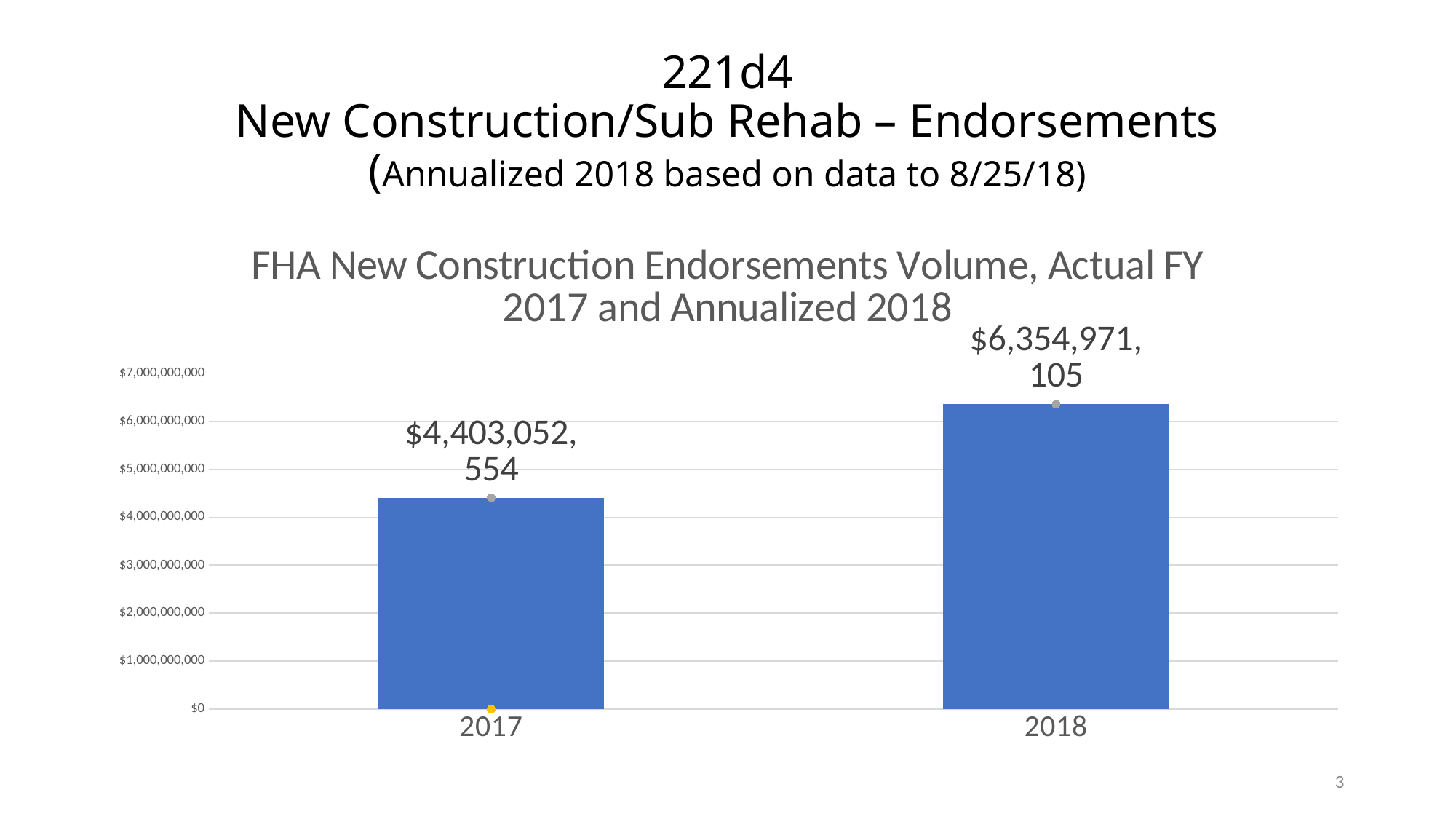
Do the values rise or fall from 2017 to 2018? rise What kind of chart is shown? bar chart What is the title of the chart? FHA New Construction Endorsements Volume, Actual FY 2017 and Annualized 2018 Which year has the higher endorsement volume? 2018 What is the value for 2018? $6,354,971,105 Is the value for 2017 larger or smaller than the value for 2018? smaller What is the difference between the 2018 and 2017 values? $1,951,918,551 Which year has the lower endorsement volume? 2017 How many years are shown on the x axis? 2 Is the value for 2017 greater or less than $5,000,000,000? less Is the value for 2018 greater or less than $6,000,000,000? greater What is the value for 2017? $4,403,052,554